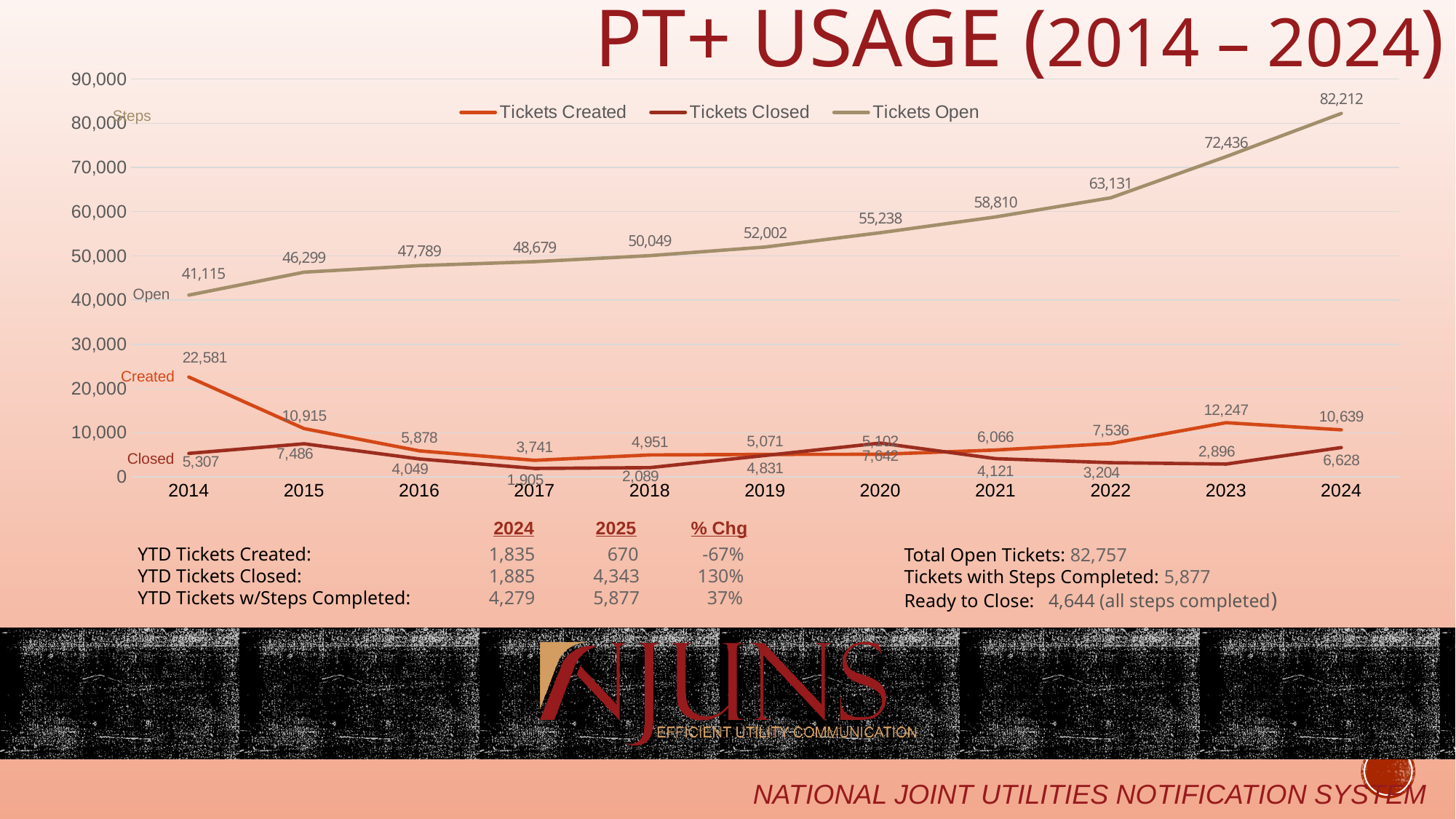
What is the value of Tickets Closed in 2017? 1,905 What is the value of Tickets Open in 2019? 52,002 In which year is Tickets Closed lowest? 2017 In 2023, which is larger: Tickets Created or Tickets Closed? Tickets Created How many years are plotted on the x axis? 11 What is the value of Tickets Open in 2024? 82,212 What is the difference between Tickets Open in 2024 and in 2023? 9,776 How many series does the legend list? 3 In which year is Tickets Open highest? 2024 What is the value of Tickets Created in 2014? 22,581 What is the difference between Tickets Created in 2014 and in 2015? 11,666 In which year is Tickets Created highest? 2014